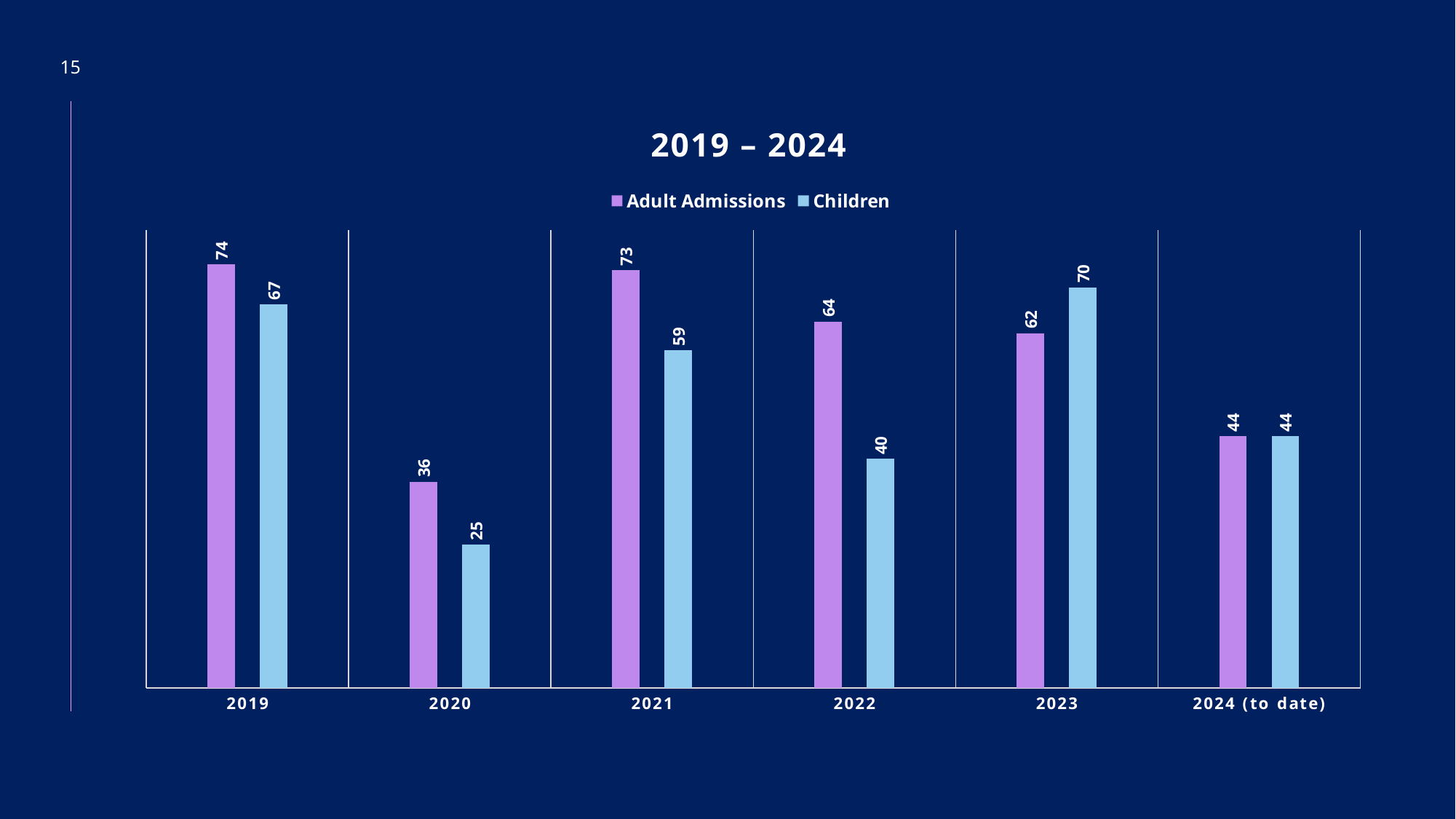
Which series is shown in purple? Adult Admissions What kind of chart is shown on the slide? Bar chart Which year has the highest value for Adult Admissions? 2019 How many year categories are shown on the x axis? 6 What is the value for Adult Admissions in 2019? 74 What is the title of the chart? 2019 – 2024 How many series does the legend list? 2 What is the value for Children in 2022? 40 What is the difference between Adult Admissions and Children in 2021? 14 What is the value for Children in 2024 (to date)? 44 Which is larger in 2023, Adult Admissions or Children? Children Which year has the lowest value for Children? 2020